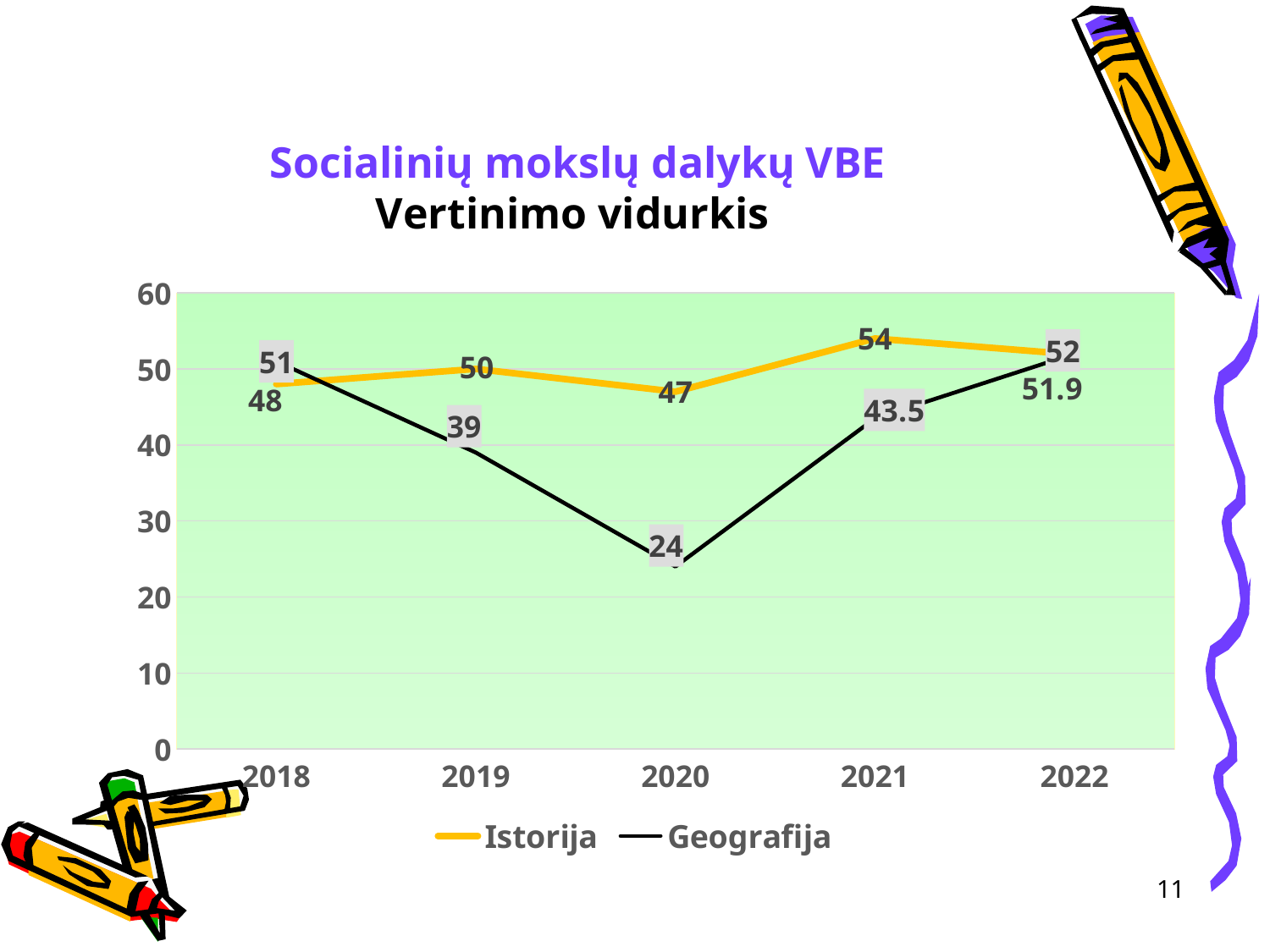
What is the Geografija value for 2022? 52 In which year is the Geografija value lowest? 2020 Does the Geografija value rise or fall from 2018 to 2020? Fall In which year is the Istorija value highest? 2021 What is the Istorija value for 2018? 48 How many years are shown on the x axis? 5 What is the Istorija value for 2021? 54 How many series does the legend list? 2 Which series has the larger value in 2018, Istorija or Geografija? Geografija What is the difference between the Istorija and Geografija values in 2020? 23 What kind of chart is shown on the slide? Line chart What is the Geografija value for 2020? 24